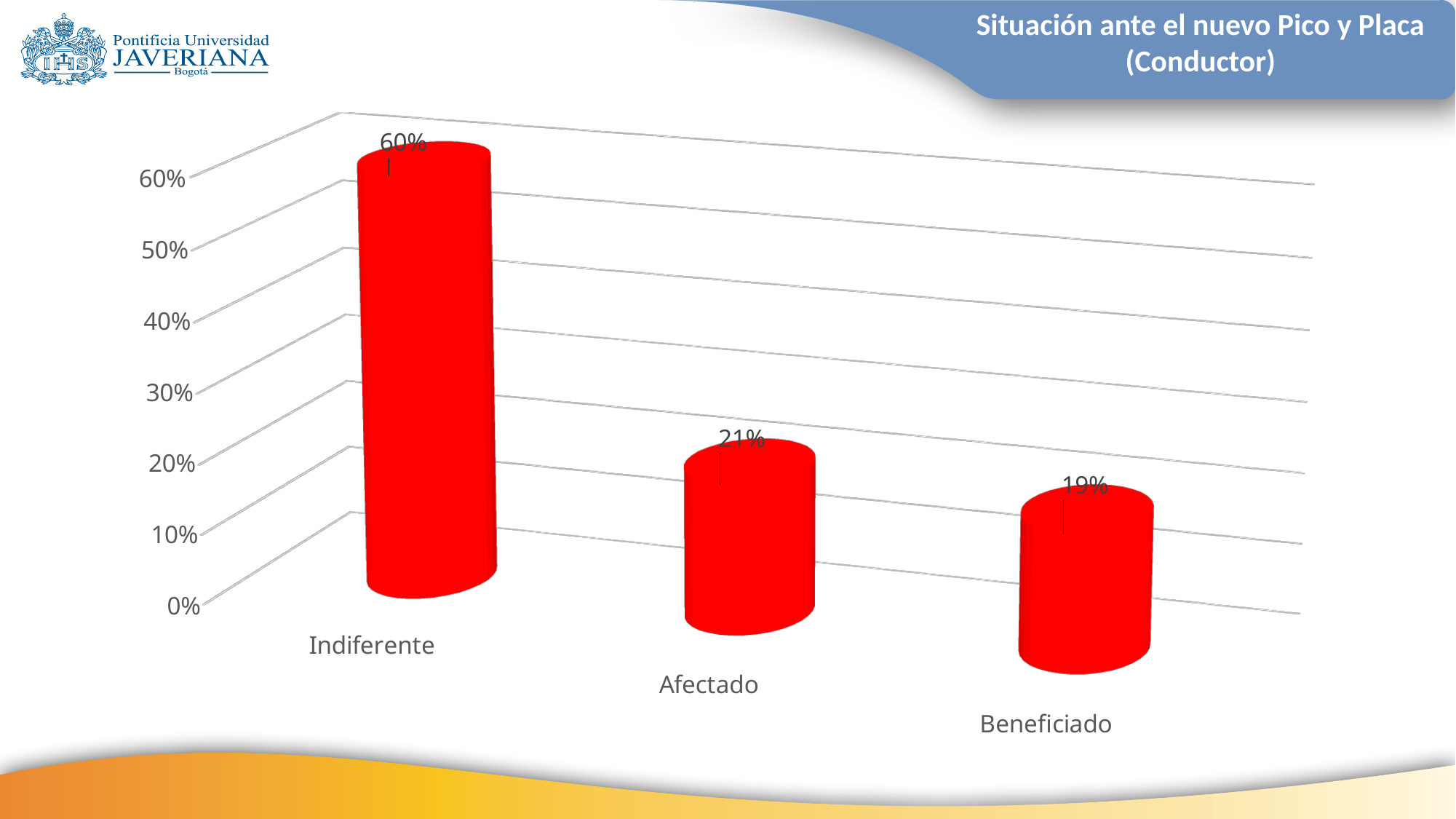
Which category has the lowest value? Beneficiado What is the difference between the values for Afectado and Beneficiado? 2% How many categories are shown in the chart? 3 What kind of chart is shown on the slide? bar chart Is the value for Indiferente greater or less than 50%? greater Which category has the highest value? Indiferente What is the value for Indiferente? 60% Which is larger, the value for Indiferente or the value for Beneficiado? Indiferente What is the difference between the values for Indiferente and Afectado? 39% What is the value for Afectado? 21% What is the value for Beneficiado? 19% What is the title of the chart? Situación ante el nuevo Pico y Placa (Conductor)